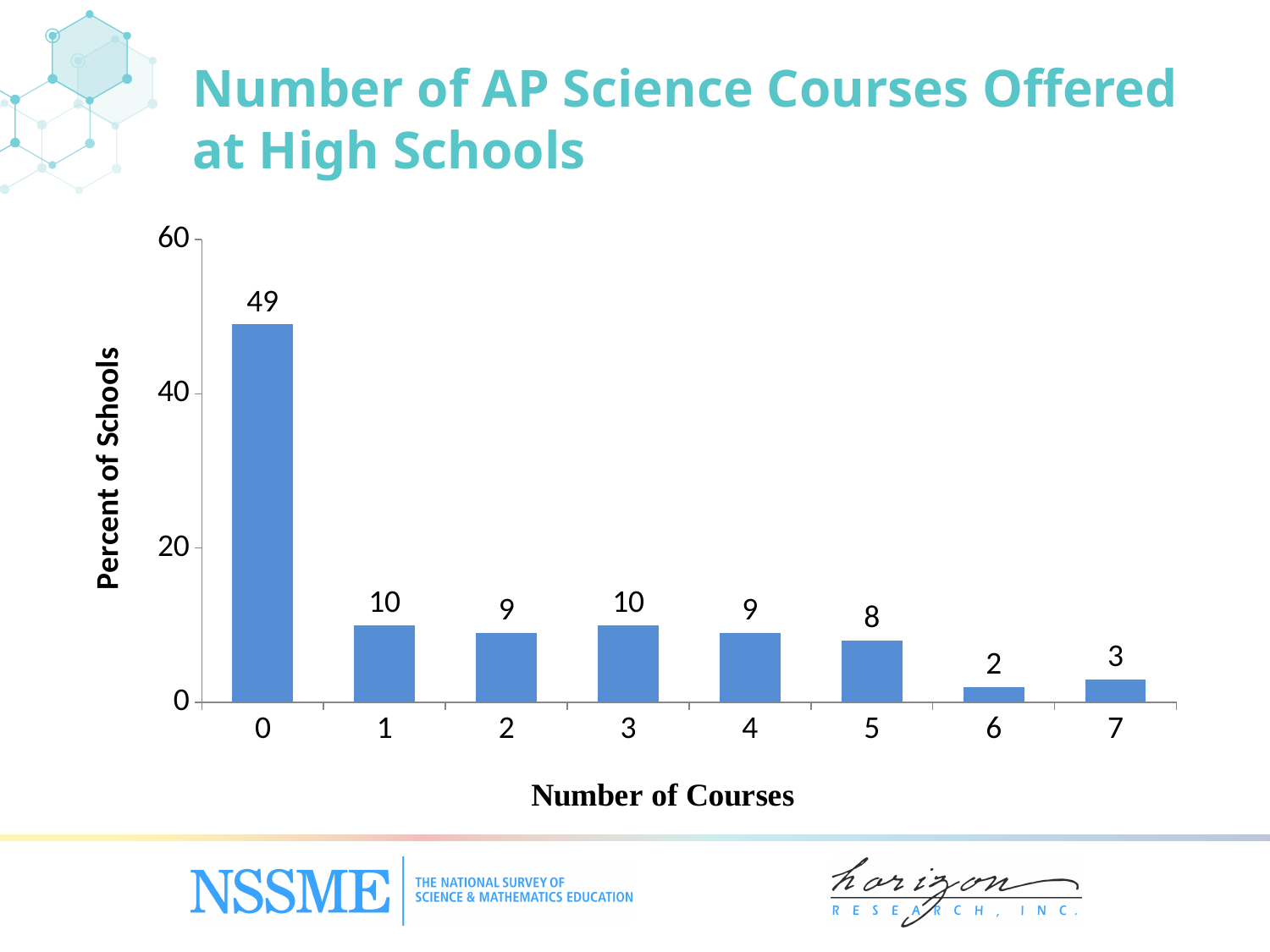
What percent of schools offer 0 AP science courses? 49 Is the value for 0 courses greater or less than 40? greater Which number of courses has the lowest percent of schools? 6 How many categories (numbers of courses) are shown on the x axis? 8 Which number of courses has the highest percent of schools? 0 What kind of chart is shown on the slide? bar chart What percent of schools offer 5 AP science courses? 8 What percent of schools offer 7 AP science courses? 3 Which has a larger percent of schools, 4 courses or 7 courses? 4 courses What is the difference in percent of schools between 5 courses and 6 courses? 6 What is the difference in percent of schools between 0 courses and 1 course? 39 What is the label of the y axis? Percent of Schools